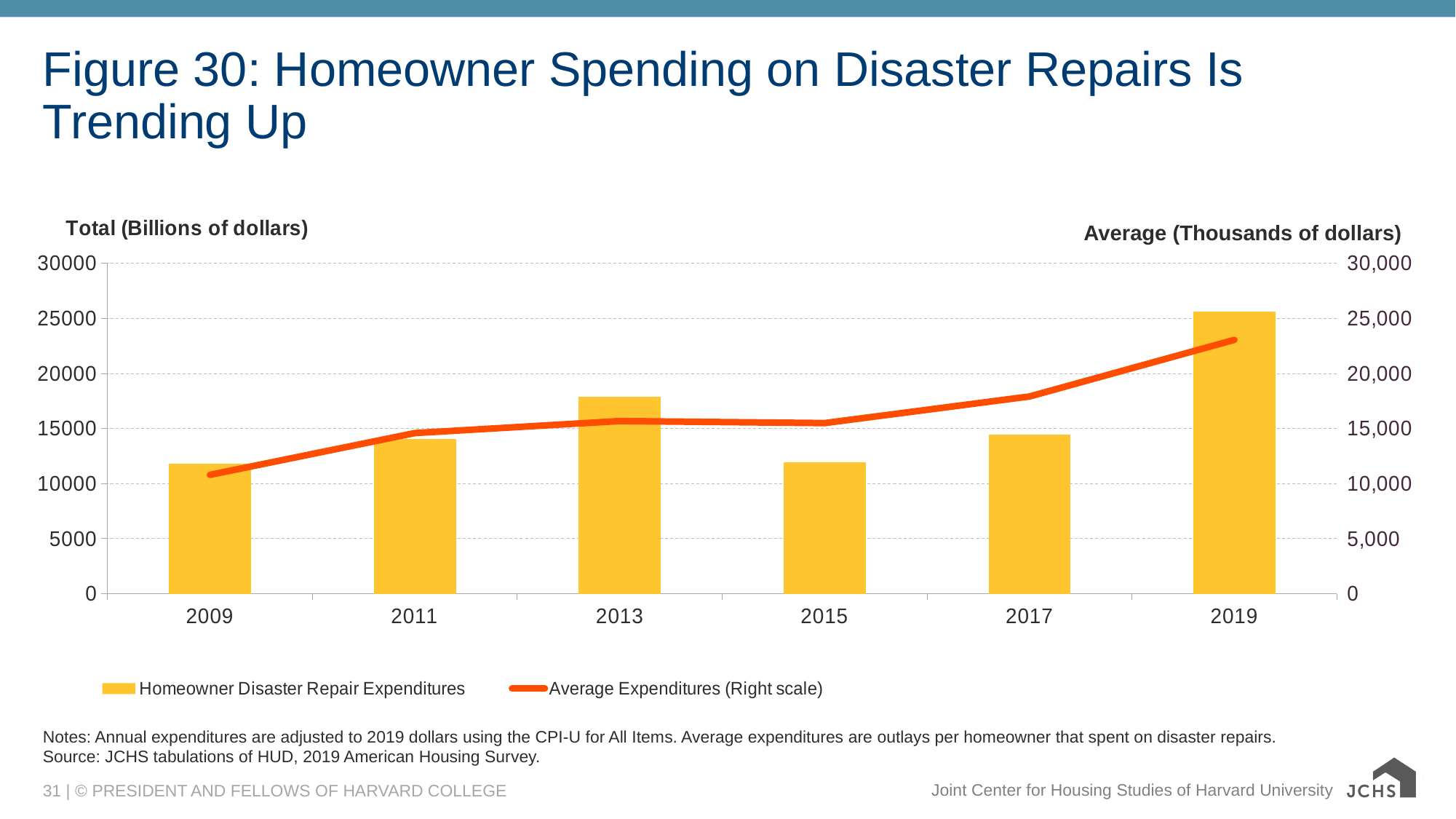
Is the Average Expenditures value for 2009 greater or less than 15,000? less Does the Average Expenditures line generally rise or fall from 2009 to 2019? rise Is the Average Expenditures value for 2019 greater or less than 20,000? greater What is the label of the right-hand axis? Average (Thousands of dollars) How many years are shown on the x axis? 6 Which is larger, the Homeowner Disaster Repair Expenditures bar for 2013 or for 2011? 2013 Is the Homeowner Disaster Repair Expenditures bar for 2013 greater or less than 15000? greater Which year has the highest bar for Homeowner Disaster Repair Expenditures? 2019 How many series does the legend list? 2 What kind of chart is used for Homeowner Disaster Repair Expenditures? bar chart